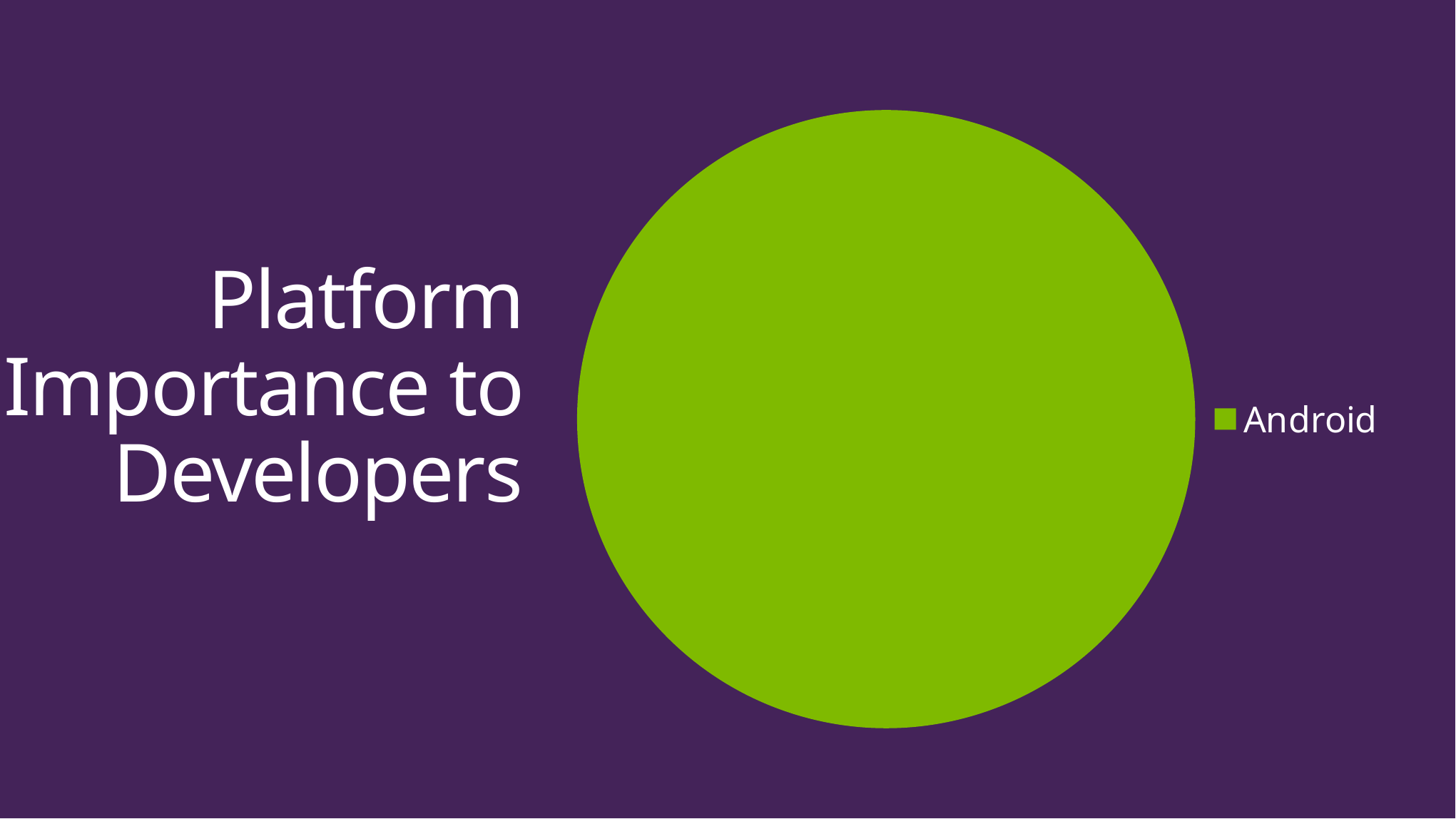
How many slices does the pie chart have? 1 What kind of chart is shown on the slide? pie chart How many entries does the chart's legend list? 1 Which category has the largest slice in the pie chart? Android What colour is the Android slice in the pie chart? green Which category is listed in the chart's legend? Android